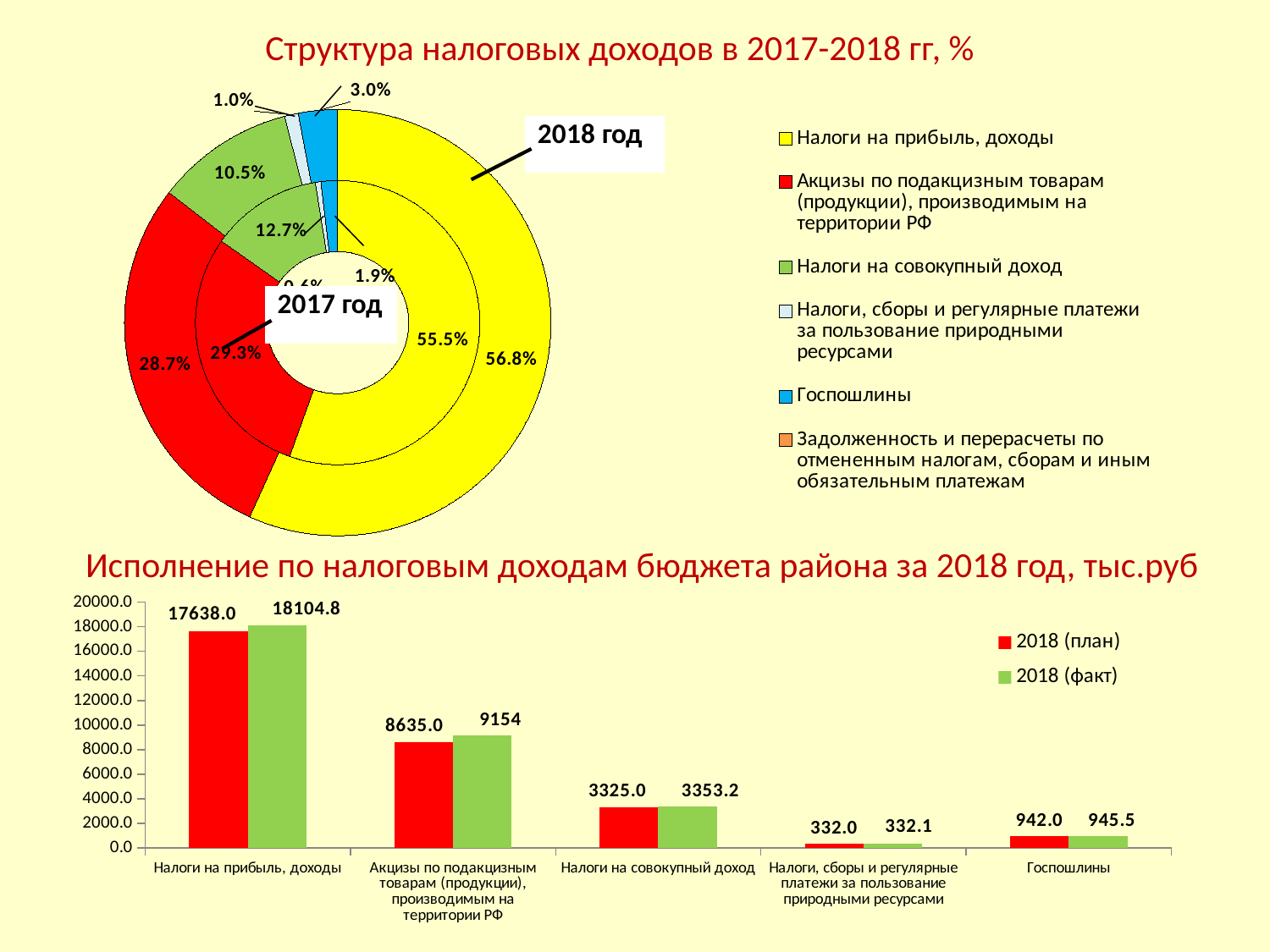
On the chart 'Структура налоговых доходов в 2017-2018 гг, %', what share does 'Налоги на прибыль, доходы' have in the 2018 ring? 56.8% On the chart 'Структура налоговых доходов в 2017-2018 гг, %', how many entries does the legend list? 6 On the chart 'Исполнение по налоговым доходам бюджета района за 2018 год, тыс.руб', how many categories are shown on the x axis? 5 What kind of chart is 'Исполнение по налоговым доходам бюджета района за 2018 год, тыс.руб'? bar chart On the chart 'Структура налоговых доходов в 2017-2018 гг, %', what share does 'Налоги на совокупный доход' have in the 2017 ring? 12.7% On the chart 'Исполнение по налоговым доходам бюджета района за 2018 год, тыс.руб', which category has the lowest 2018 (план) value? Налоги, сборы и регулярные платежи за пользование природными ресурсами On the chart 'Структура налоговых доходов в 2017-2018 гг, %', what share does 'Госпошлины' have in the 2018 ring? 3.0% On the chart 'Исполнение по налоговым доходам бюджета района за 2018 год, тыс.руб', what is the 2018 (факт) value for 'Налоги на прибыль, доходы'? 18104.8 On the chart 'Структура налоговых доходов в 2017-2018 гг, %', what is the difference between the 2018 and 2017 shares of 'Акцизы по подакцизным товарам (продукции), производимым на территории РФ'? 0.6% On the chart 'Исполнение по налоговым доходам бюджета района за 2018 год, тыс.руб', what is the 2018 (план) value for 'Госпошлины'? 942.0 On the chart 'Структура налоговых доходов в 2017-2018 гг, %', which category has the largest share in the 2018 ring? Налоги на прибыль, доходы On the chart 'Исполнение по налоговым доходам бюджета района за 2018 год, тыс.руб', what is the difference between the 2018 (факт) and 2018 (план) values for 'Акцизы по подакцизным товарам (продукции), производимым на территории РФ'? 519